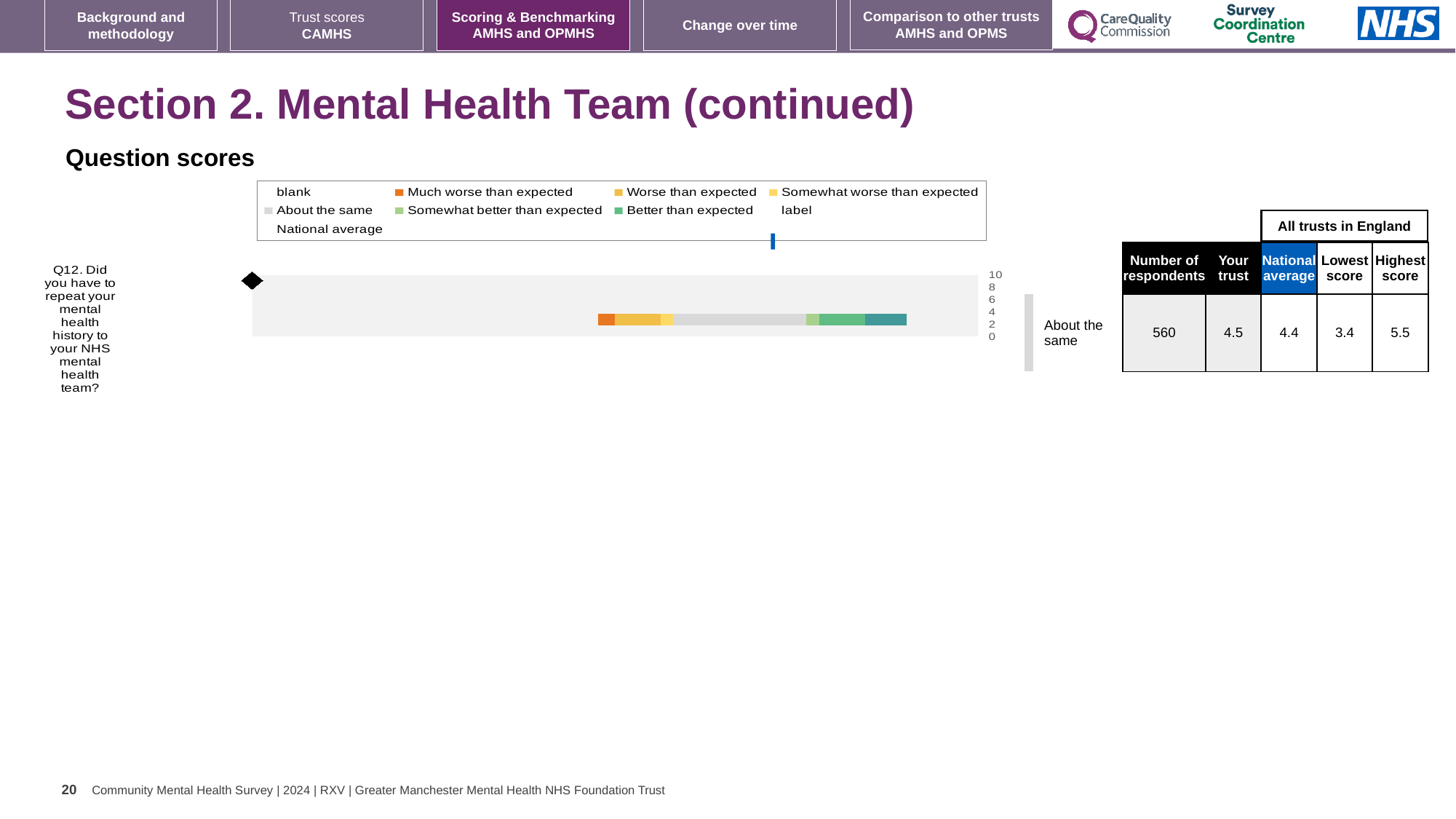
For Q12, which is higher: the 'Your trust' score or the national average? Your trust Which question is plotted in the chart? Q12. Did you have to repeat your mental health history to your NHS mental health team? How many survey questions are plotted in the chart? 1 What is the national average score for Q12? 4.4 What kind of chart is used to show the Q12 question score? Bar chart What is the difference between the highest score and the lowest score for Q12? 2.1 What is the lowest score among all trusts in England for Q12? 3.4 What is the 'Your trust' score for Q12? 4.5 What is the difference between the 'Your trust' score and the national average for Q12? 0.1 What benchmark category label is shown to the right of the Q12 bar? About the same How many respondents answered Q12? 560 What is the highest score among all trusts in England for Q12? 5.5